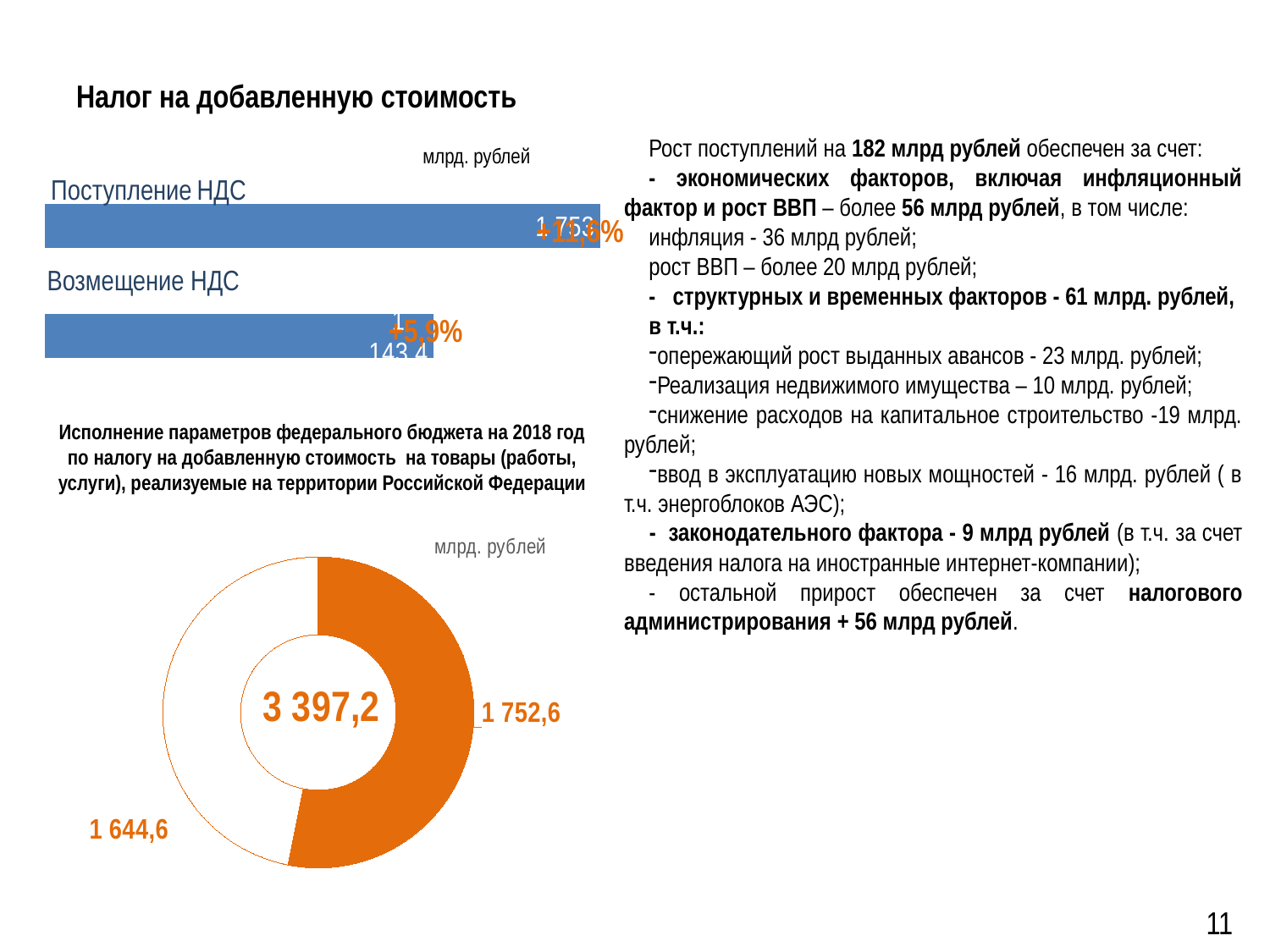
On the donut chart at the bottom left, what value is labelled on the orange segment? 1 752,6 On the donut chart at the bottom left, what value is shown in the centre of the ring? 3 397,2 On the donut chart at the bottom left, what is the total of the two segments? 3 397,2 On the bar chart at the top left, how many categories are plotted? 2 On the donut chart at the bottom left, what value is labelled on the white segment? 1 644,6 What unit is stated above the donut chart at the bottom left? млрд. рублей What kind of chart is shown at the bottom left of the slide? Donut (pie) chart On the donut chart at the bottom left, what is the difference between the two segment values 1 752,6 and 1 644,6? 108,0 On the donut chart at the bottom left, which segment is larger, the one labelled 1 752,6 or the one labelled 1 644,6? 1 752,6 What kind of chart is shown at the top left of the slide, under the heading 'Налог на добавленную стоимость'? Bar chart On the donut chart at the bottom left, how many segments does the ring have? 2 On the bar chart at the top left, which bar is longer, 'Поступление НДС' or 'Возмещение НДС'? Поступление НДС